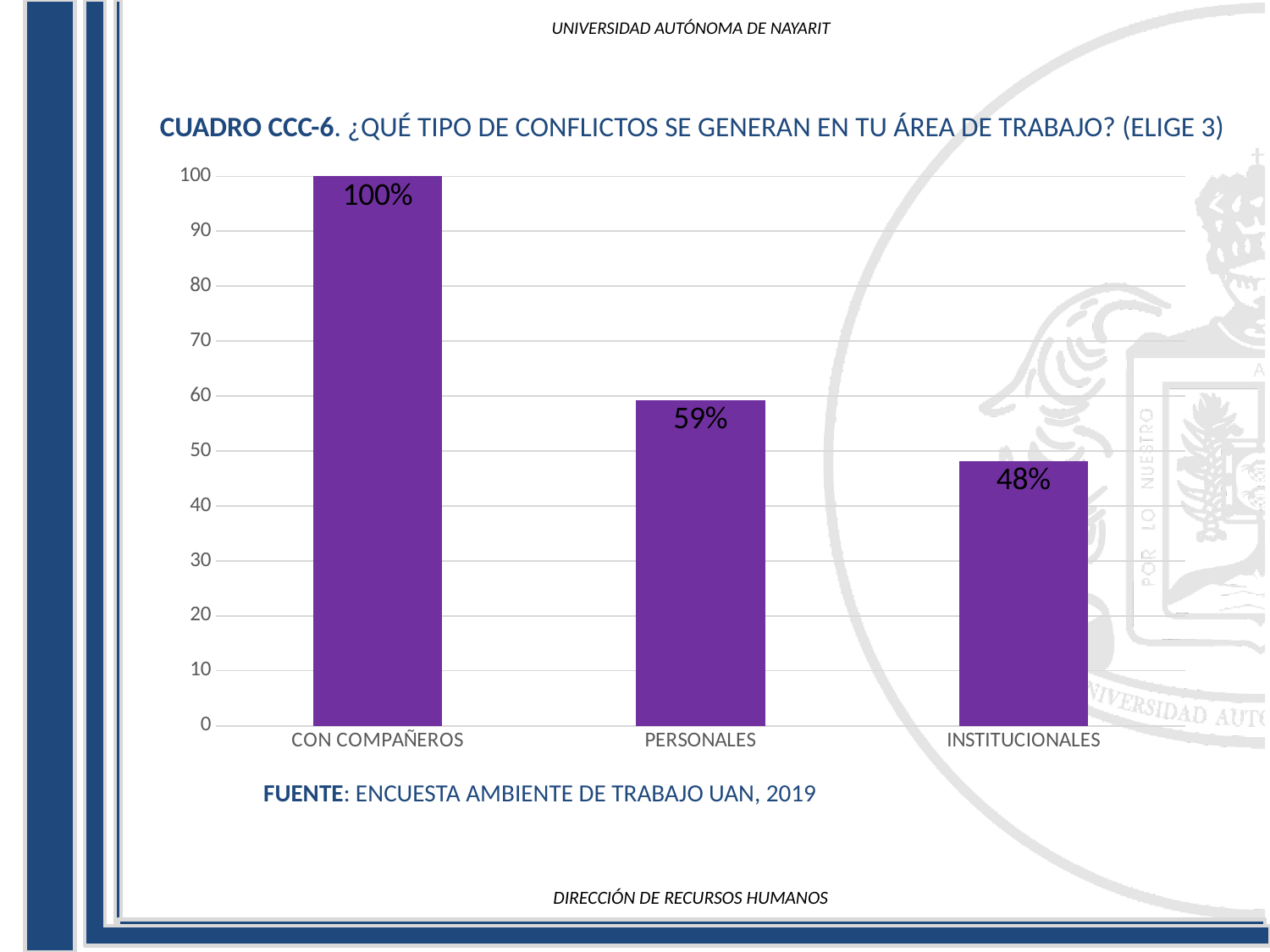
Do the values rise or fall from left to right across the categories? fall Is the value for INSTITUCIONALES greater or less than 50? less What is the difference between the values for PERSONALES and INSTITUCIONALES? 11% What is the value for PERSONALES? 59% How many categories are shown in the chart? 3 What is the value for CON COMPAÑEROS? 100% Which is larger, the value for PERSONALES or the value for INSTITUCIONALES? PERSONALES Which category has the lowest value? INSTITUCIONALES Which category has the highest value? CON COMPAÑEROS What kind of chart is shown on the slide? bar chart What is the value for INSTITUCIONALES? 48% What is the difference between the values for CON COMPAÑEROS and PERSONALES? 41%